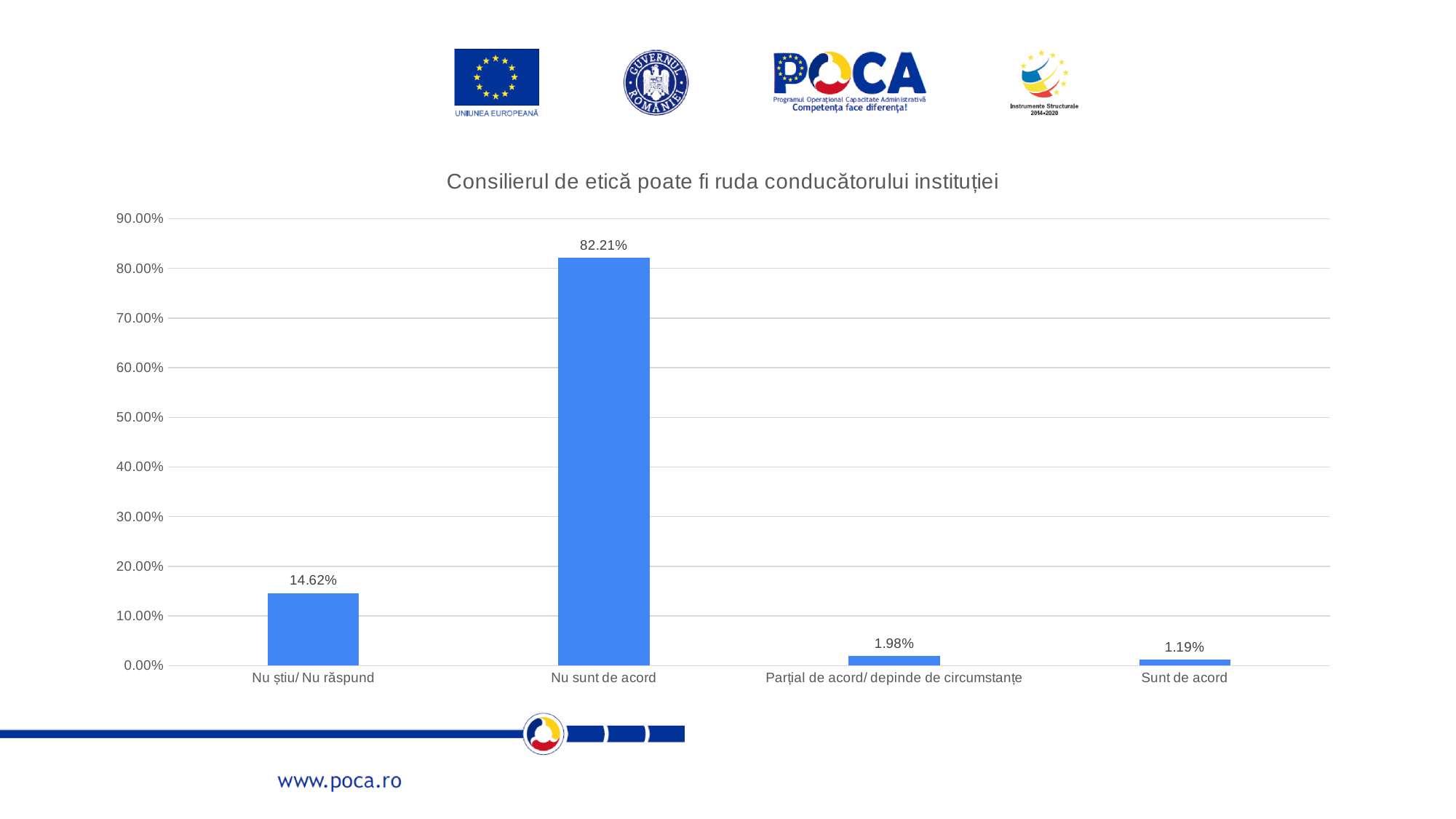
Is the value for "Nu sunt de acord" greater or less than 80.00%? greater Which category has the highest value? Nu sunt de acord What is the value for "Nu știu/ Nu răspund"? 14.62% What is the value for "Sunt de acord"? 1.19% What is the value for "Parțial de acord/ depinde de circumstanțe"? 1.98% What is the value for "Nu sunt de acord"? 82.21% Which is larger, the value for "Nu știu/ Nu răspund" or the value for "Parțial de acord/ depinde de circumstanțe"? Nu știu/ Nu răspund How many categories are shown on the x axis? 4 What is the difference between the values for "Nu sunt de acord" and "Nu știu/ Nu răspund"? 67.59% What kind of chart is shown on the slide? Bar chart Which category has the lowest value? Sunt de acord What is the title of the chart? Consilierul de etică poate fi ruda conducătorului instituției